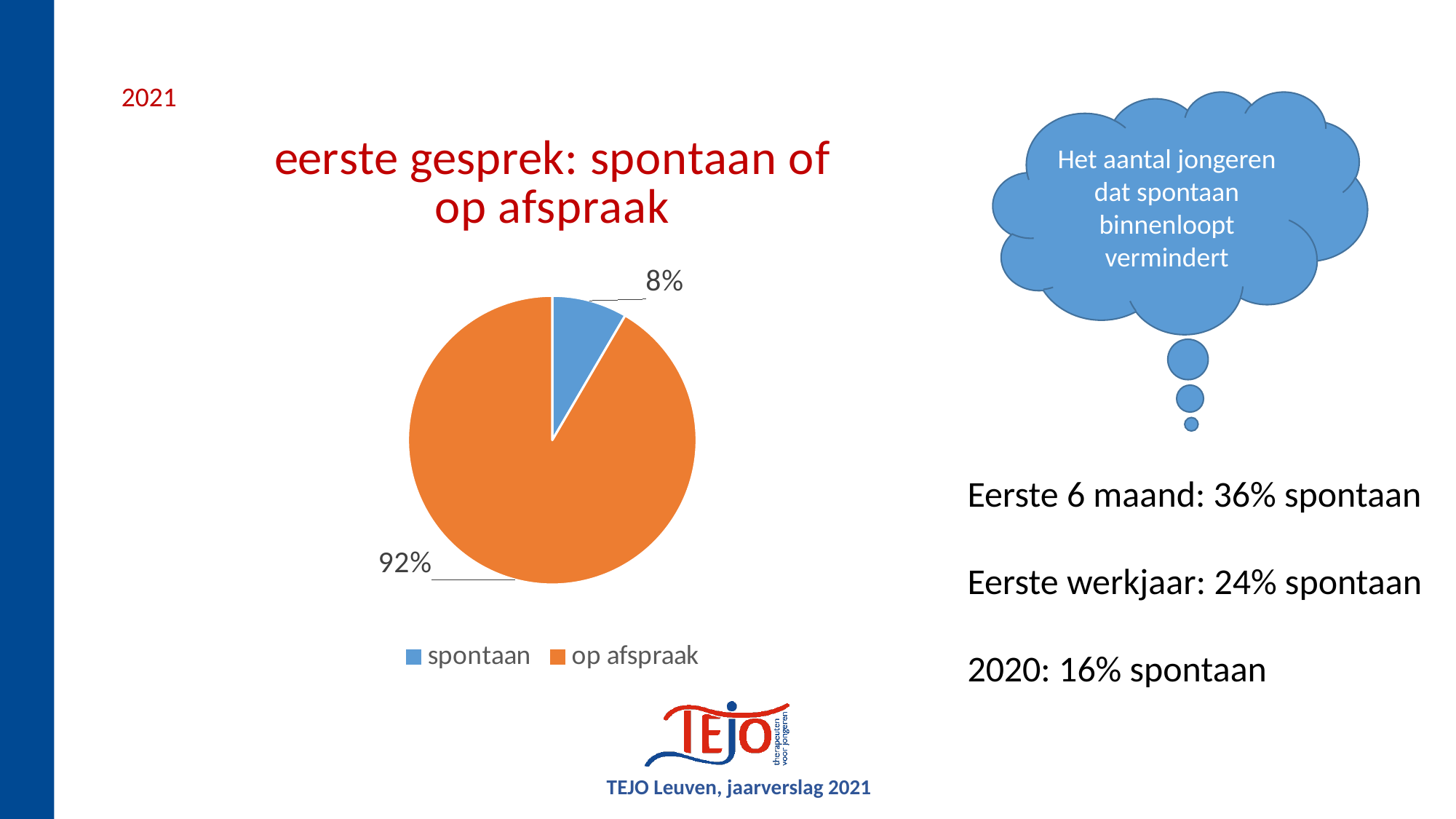
Which is larger, the slice for 'spontaan' or the slice for 'op afspraak'? op afspraak What is the title of the chart? eerste gesprek: spontaan of op afspraak How many categories does the pie chart show? 2 What share of the pie does 'op afspraak' represent? 92% What colour is the 'spontaan' slice? blue Which category has the smallest slice of the pie? spontaan Which category has the largest slice of the pie? op afspraak What share of the pie does 'spontaan' represent? 8% What kind of chart is shown on the slide? pie chart How many entries does the legend list? 2 What is the difference in percentage points between 'op afspraak' and 'spontaan'? 84